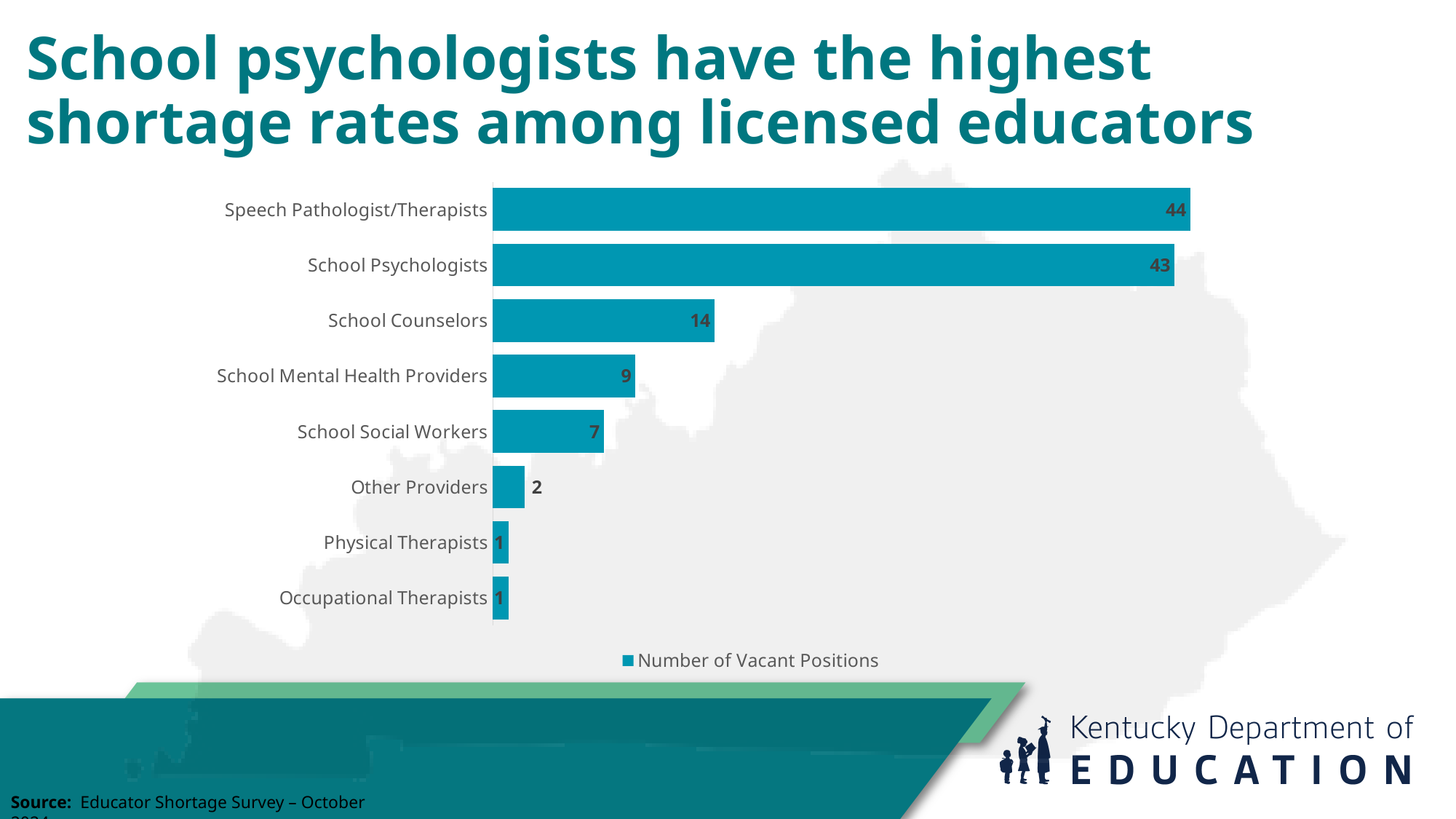
Which has more vacant positions, School Mental Health Providers or School Social Workers? School Mental Health Providers How many categories are shown in the chart? 8 What is the legend entry for the series in the chart? Number of Vacant Positions What is the number of vacant positions for School Social Workers? 7 What is the difference in vacant positions between Speech Pathologist/Therapists and School Psychologists? 1 What kind of chart is shown on the slide? Bar chart What is the number of vacant positions for School Counselors? 14 How many series does the legend list? 1 What is the difference in vacant positions between School Counselors and School Mental Health Providers? 5 What is the number of vacant positions for Speech Pathologist/Therapists? 44 Which category has the highest number of vacant positions? Speech Pathologist/Therapists What is the number of vacant positions for School Psychologists? 43